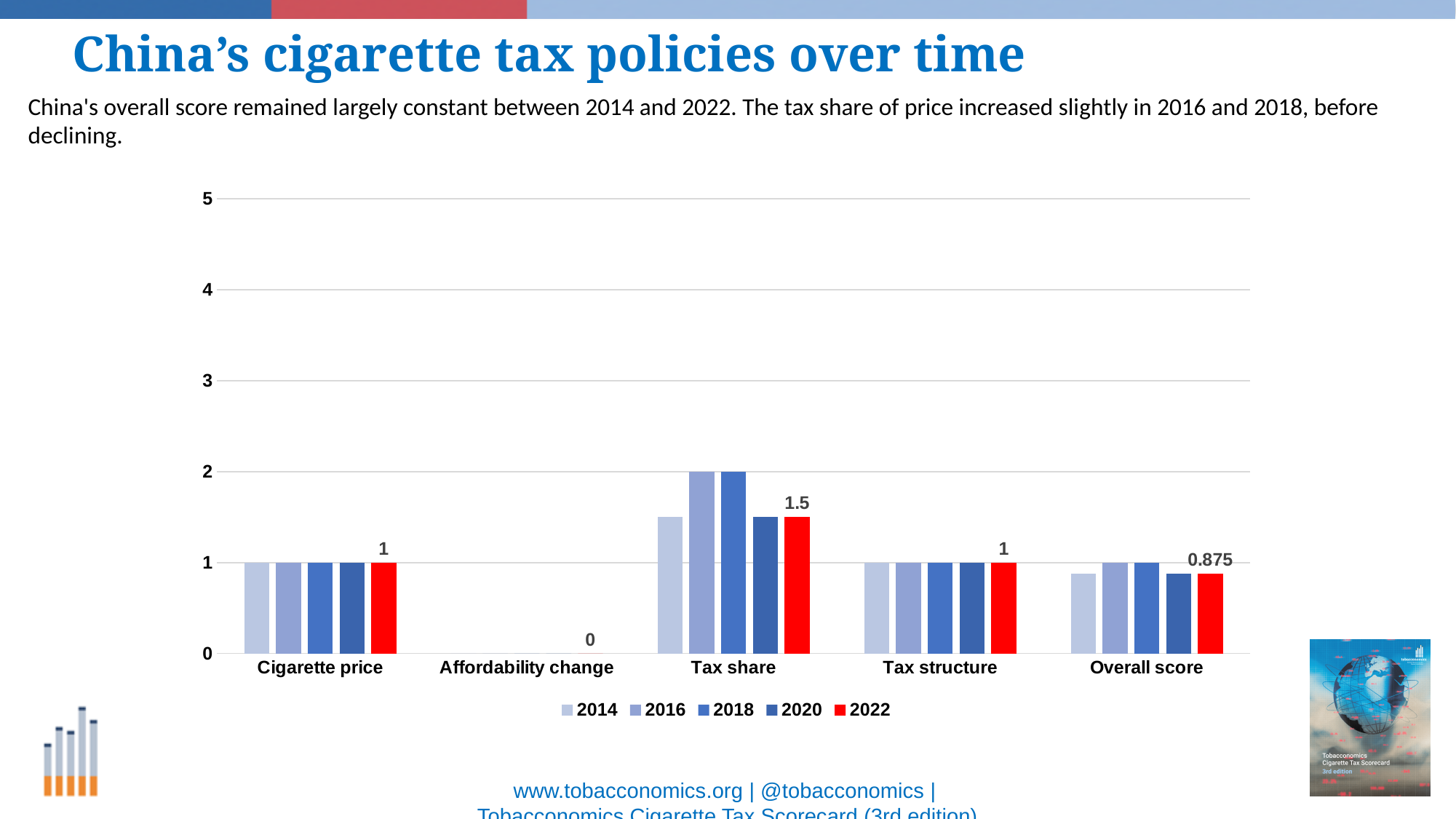
What is the value for Tax share in 2022? 1.5 Which category has the lowest value for 2022? Affordability change What is the value for Tax share in 2018? 2 What kind of chart is shown on the slide? bar chart How many categories are shown on the x axis? 5 Which category has the highest value for 2022? Tax share What is the difference between the 2022 values for Tax share and Overall score? 0.625 Is the value for Overall score in 2014 greater or less than 1? less What is the value for Affordability change in 2022? 0 How many series does the legend list? 5 Which is larger in 2022: Tax share or Tax structure? Tax share What is the value for Overall score in 2022? 0.875